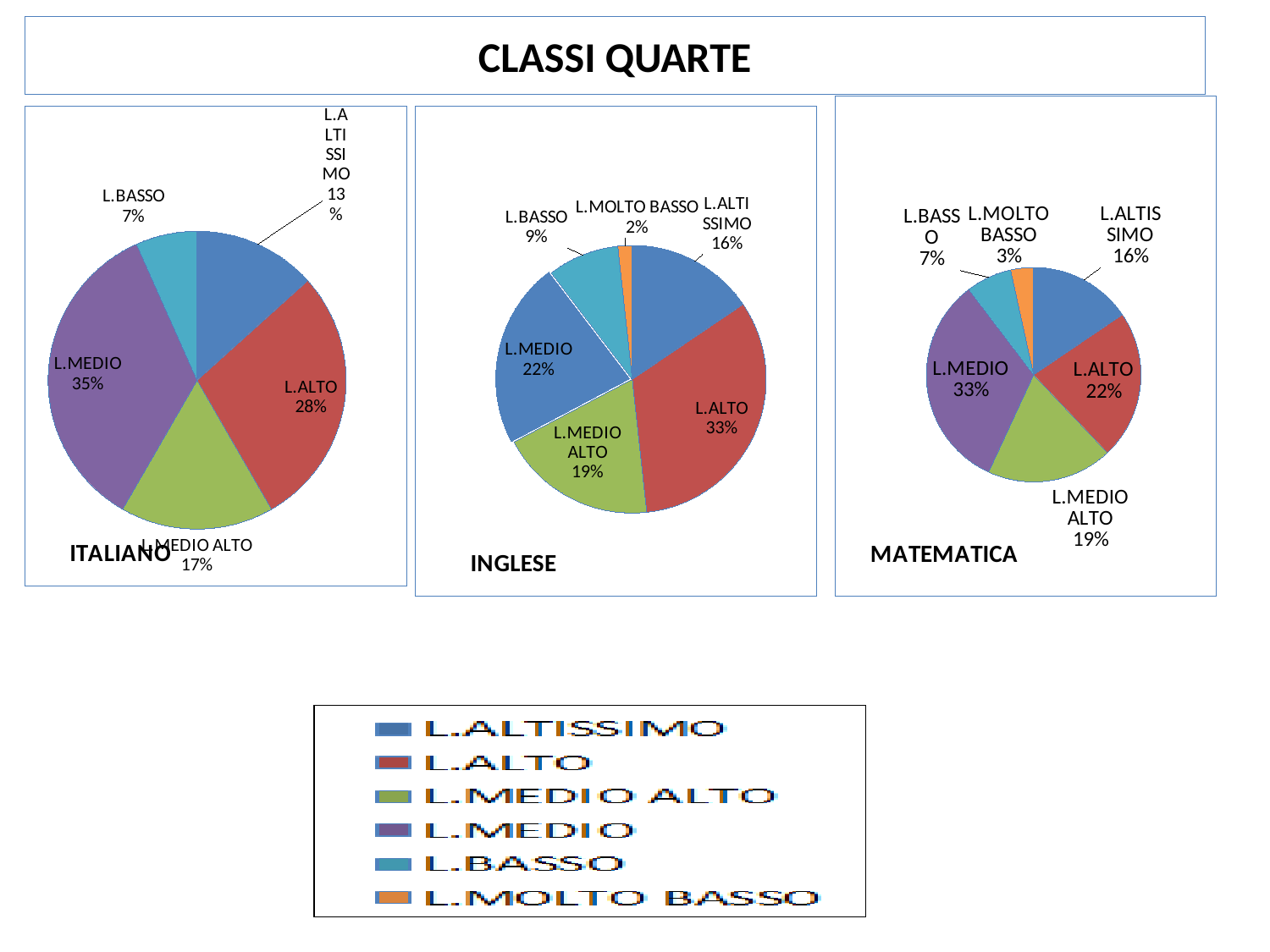
In the MATEMATICA pie chart, what is the difference between the L.ALTO share and the L.BASSO share? 15% In the INGLESE pie chart, what share is L.ALTO? 33% What type of chart is used for ITALIANO, INGLESE and MATEMATICA? Pie chart In the INGLESE pie chart, what share is L.MOLTO BASSO? 2% How many entries does the legend at the bottom of the slide list? 6 In the ITALIANO pie chart, what share is L.ALTISSIMO? 13% How many slices does the INGLESE pie chart have? 6 In the ITALIANO pie chart, which level has the smallest share? L.BASSO In the INGLESE pie chart, which level has the largest share? L.ALTO In the MATEMATICA pie chart, which is larger, L.ALTISSIMO or L.ALTO? L.ALTO